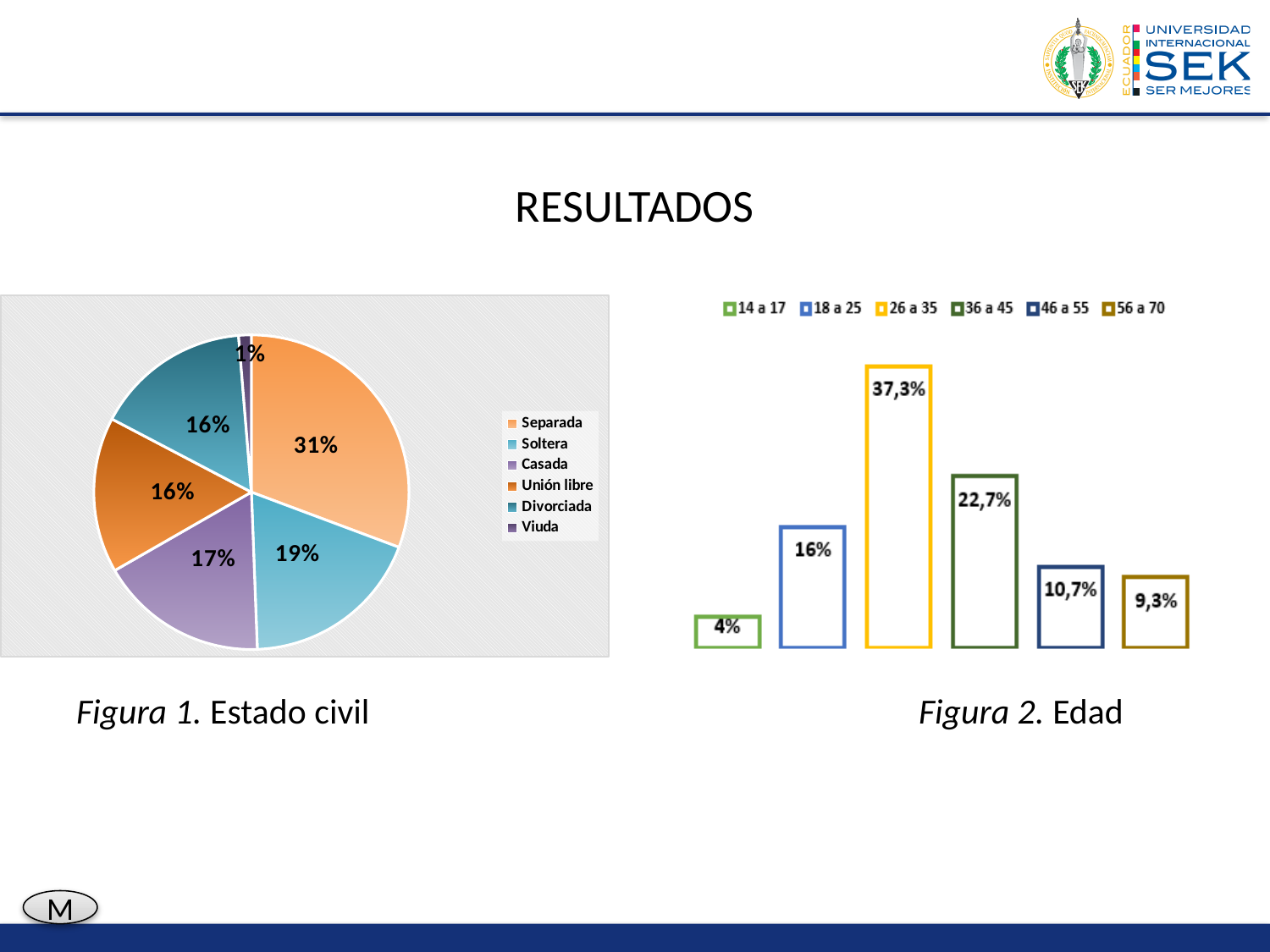
In Figura 1 (Estado civil), which category has the largest slice? Separada In Figura 2 (Edad), which is larger, 36 a 45 or 18 a 25? 36 a 45 In Figura 2 (Edad), what is the value for the 46 a 55 group? 10,7% In Figura 1 (Estado civil), what share of the pie is Separada? 31% What kind of chart is Figura 1 (Estado civil)? Pie chart In Figura 2 (Edad), what is the value for the 26 a 35 group? 37,3% In Figura 1 (Estado civil), what is the difference between the Separada and Casada percentages? 14% In Figura 1 (Estado civil), what percentage is shown for Soltera? 19% What kind of chart is Figura 2 (Edad)? Bar chart In Figura 1 (Estado civil), how many categories does the legend list? 6 In Figura 2 (Edad), which age group has the lowest value? 14 a 17 In Figura 1 (Estado civil), which category has the smallest slice? Viuda